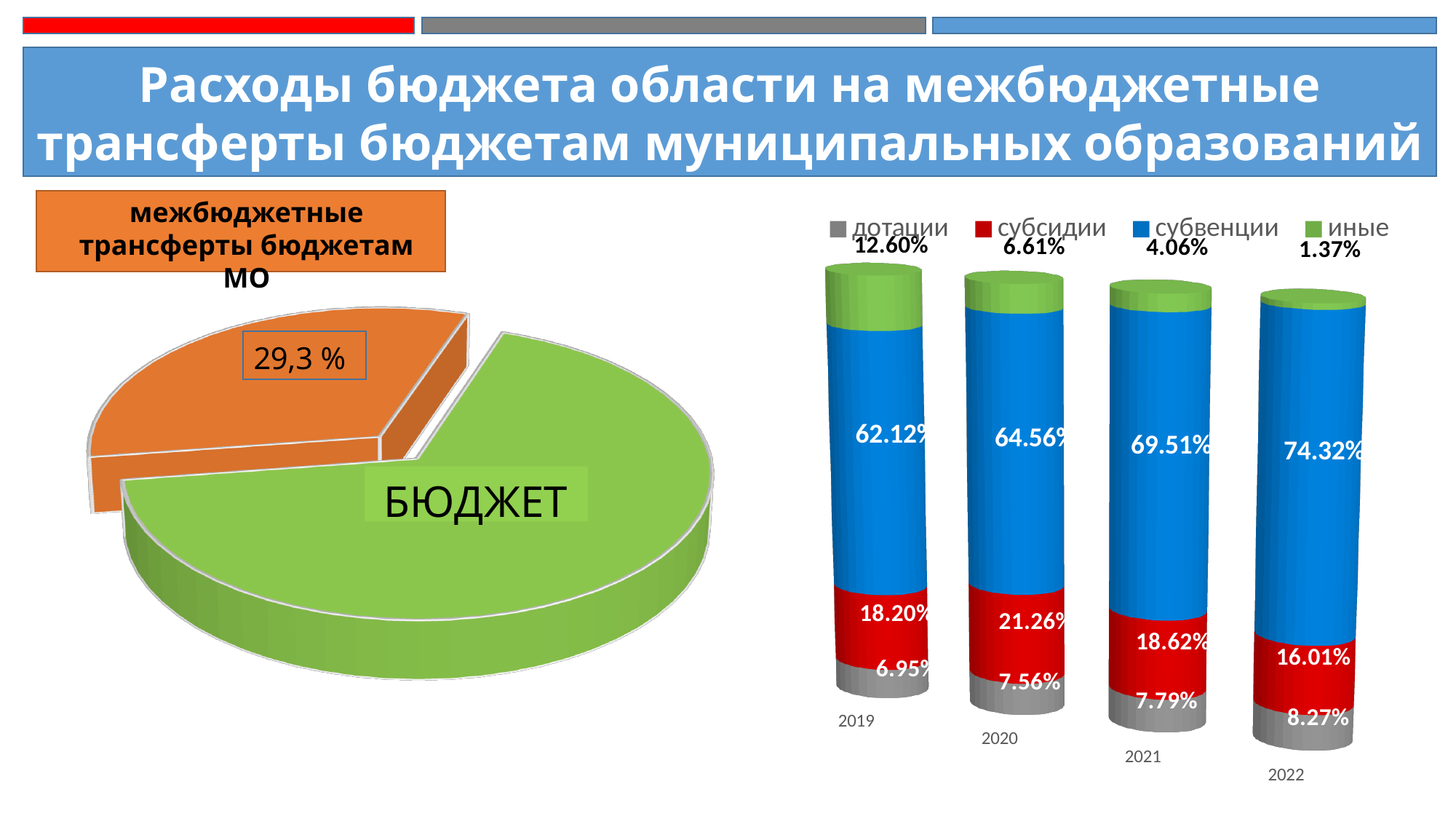
In the stacked bar chart on the right, what is the difference between the субвенции share in 2022 and in 2019? 12.20% In the stacked bar chart on the right, what is the value for иные in 2021? 4.06% In the stacked bar chart on the right, in which year is the share of субвенции highest? 2022 How many series does the legend of the stacked bar chart on the right list? 4 In the stacked bar chart on the right, what is the value for субвенции in 2022? 74.32% In the pie chart on the left, what share is shown for the orange slice (межбюджетные трансферты бюджетам МО)? 29,3 % In the stacked bar chart on the right, what is the value for дотации in 2019? 6.95% In the stacked bar chart on the right, in which year is the share of иные lowest? 2022 In the stacked bar chart on the right, which is larger: субсидии in 2020 or субсидии in 2022? субсидии in 2020 How many years are shown on the x axis of the stacked bar chart on the right? 4 In the stacked bar chart on the right, what is the value for субсидии in 2020? 21.26% In the stacked bar chart on the right, does the share of субвенции rise or fall from 2019 to 2022? rise